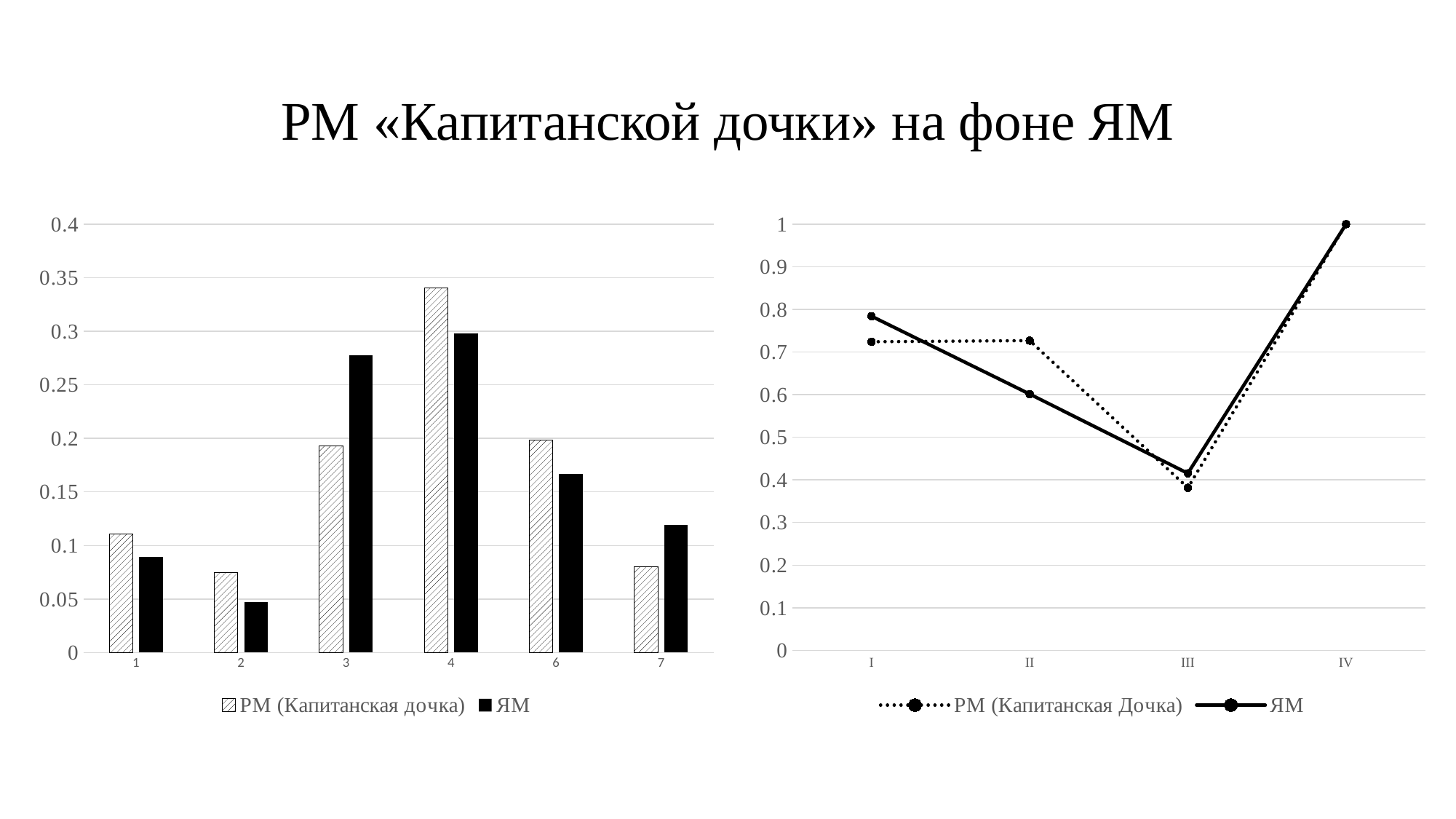
In the left bar chart, which category has the lowest value for ЯМ? 2 In the left bar chart, how many series does the legend list? 2 In the right line chart, at which category does РМ (Капитанская Дочка) reach its lowest value? III In the left bar chart, is the value for РМ (Капитанская дочка) at category 4 greater or less than 0.3? greater In the right line chart, how many points are plotted along the x axis for each series? 4 In the right line chart, is the value for ЯМ at II greater or less than 0.5? greater In the right line chart, what is the value for ЯМ at IV? 1 In the left bar chart, which category has the highest value for РМ (Капитанская дочка)? 4 In the left bar chart, how many categories are shown on the x axis? 6 What kind of chart is the chart on the left side of the slide? bar chart In the left bar chart, for category 3, which series has the larger value: РМ (Капитанская дочка) or ЯМ? ЯМ What kind of chart is the chart on the right side of the slide? line chart